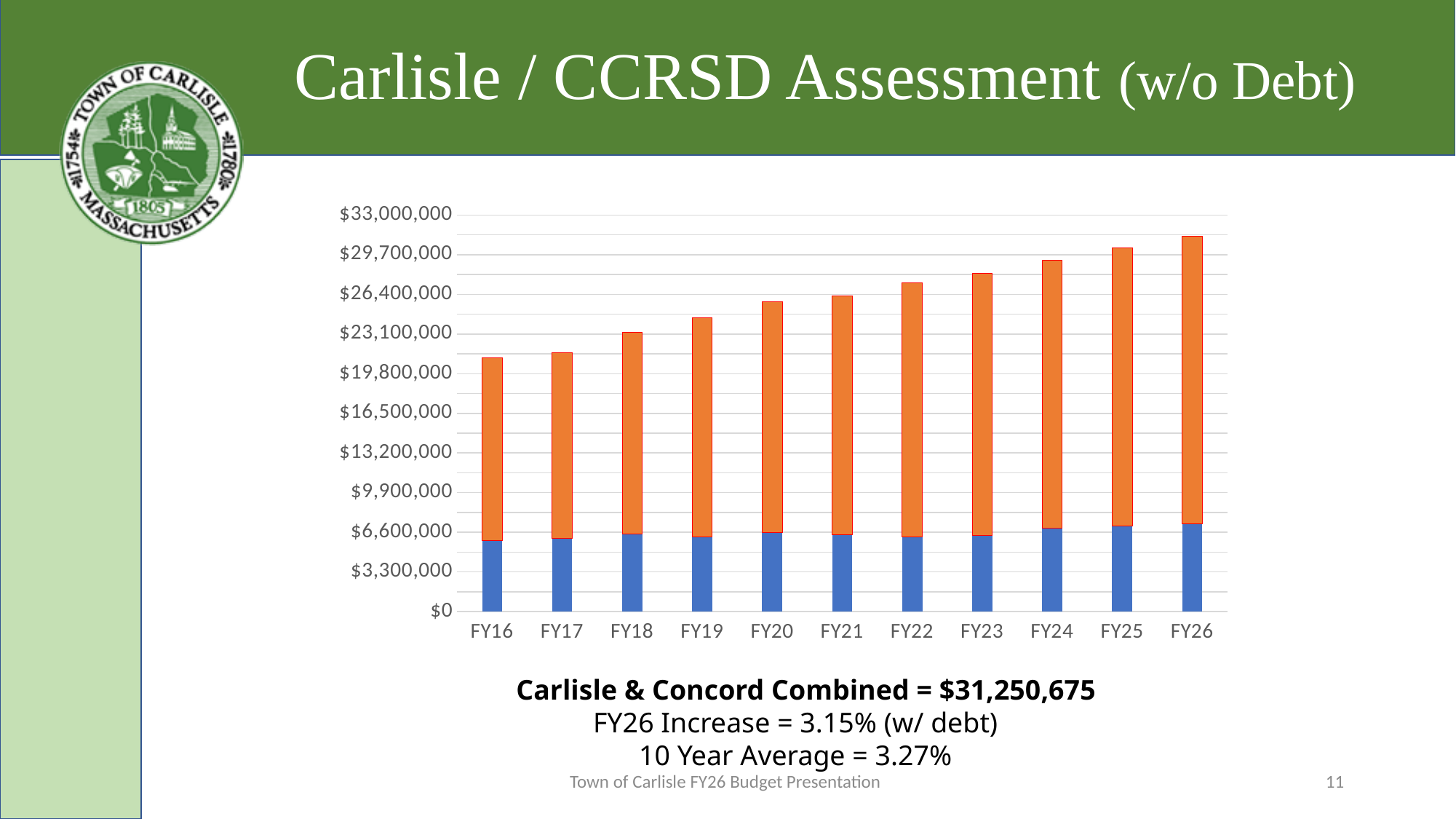
What kind of chart is shown on the slide? Stacked bar chart Which fiscal year has the shortest total bar in the chart? FY16 Do the total bar heights rise or fall from FY16 to FY26? Rise Is the total bar for FY20 greater or less than $26,400,000? less Is the total bar for FY22 greater or less than $26,400,000? greater What is the title of the slide containing the chart? Carlisle / CCRSD Assessment (w/o Debt) Is the total bar for FY26 greater or less than $29,700,000? greater Which fiscal year has the tallest total bar in the chart? FY26 Which total bar is taller, FY19 or FY24? FY24 How many fiscal years are shown on the x axis of the chart? 11